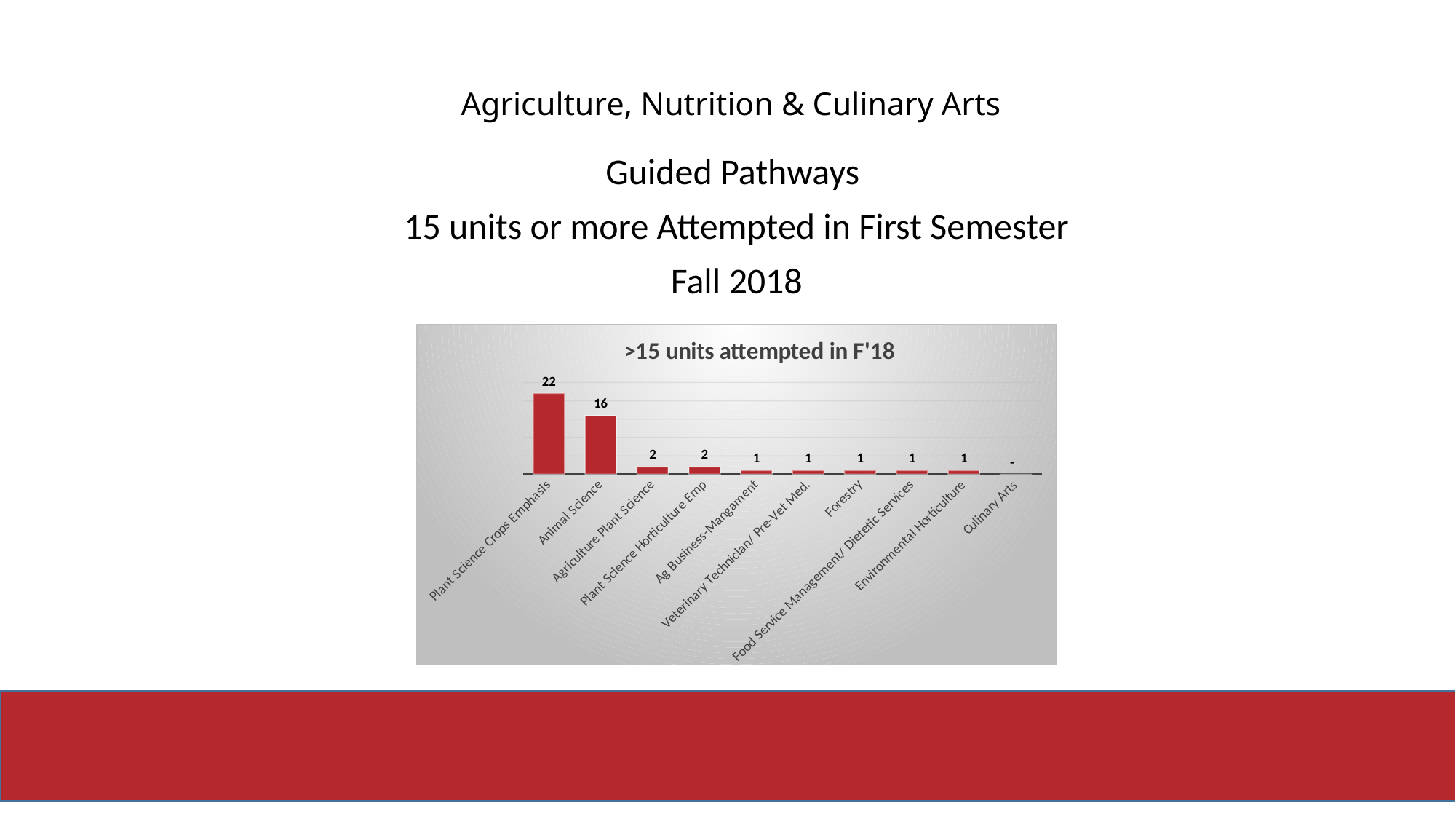
What is the value for Animal Science? 16 What is the value for Plant Science Crops Emphasis? 22 What is the value for Forestry? 1 What is the title of the chart? >15 units attempted in F'18 What kind of chart is shown? Bar chart What is the difference between the values for Plant Science Crops Emphasis and Animal Science? 6 Which is larger, the value for Animal Science or the value for Plant Science Horticulture Emp? Animal Science What colour are the bars in the chart? Red Do the values rise or fall from left to right along the x axis? Fall How many categories are shown on the x axis? 10 What is the value for Agriculture Plant Science? 2 Which category has the highest value? Plant Science Crops Emphasis